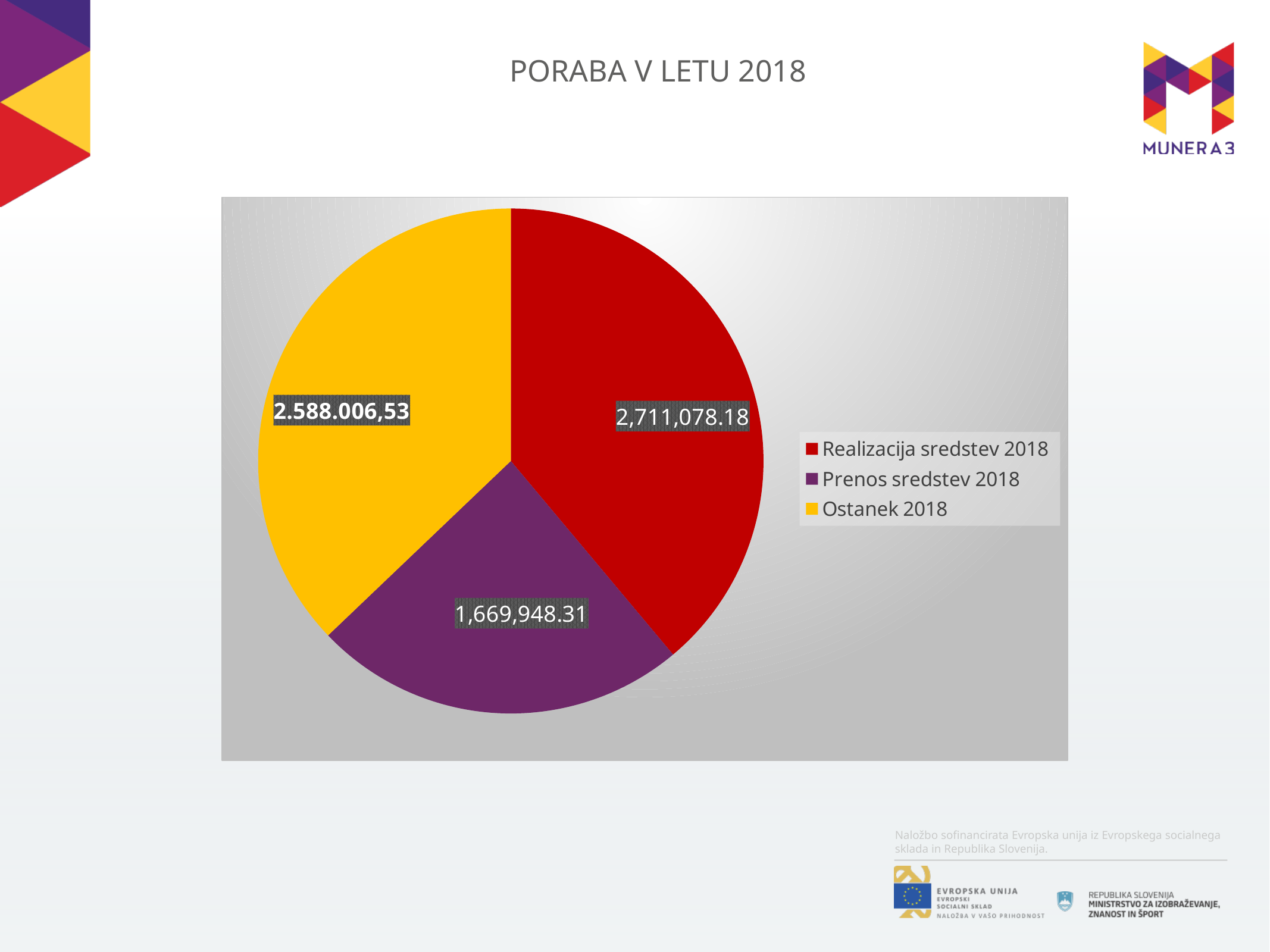
What kind of chart is shown on the slide? pie chart How many slices does the pie chart have? 3 Which colour represents Ostanek 2018 in the pie chart? yellow What is the difference between Realizacija sredstev 2018 and Prenos sredstev 2018? 1,041,129.87 Which category has the largest slice of the pie? Realizacija sredstev 2018 Which is larger, Ostanek 2018 or Prenos sredstev 2018? Ostanek 2018 What is the value for Realizacija sredstev 2018? 2,711,078.18 How many entries does the legend list? 3 What is the value for Prenos sredstev 2018? 1,669,948.31 What is the title of the slide containing the chart? PORABA V LETU 2018 Which category has the smallest slice of the pie? Prenos sredstev 2018 What is the value for Ostanek 2018? 2.588.006,53